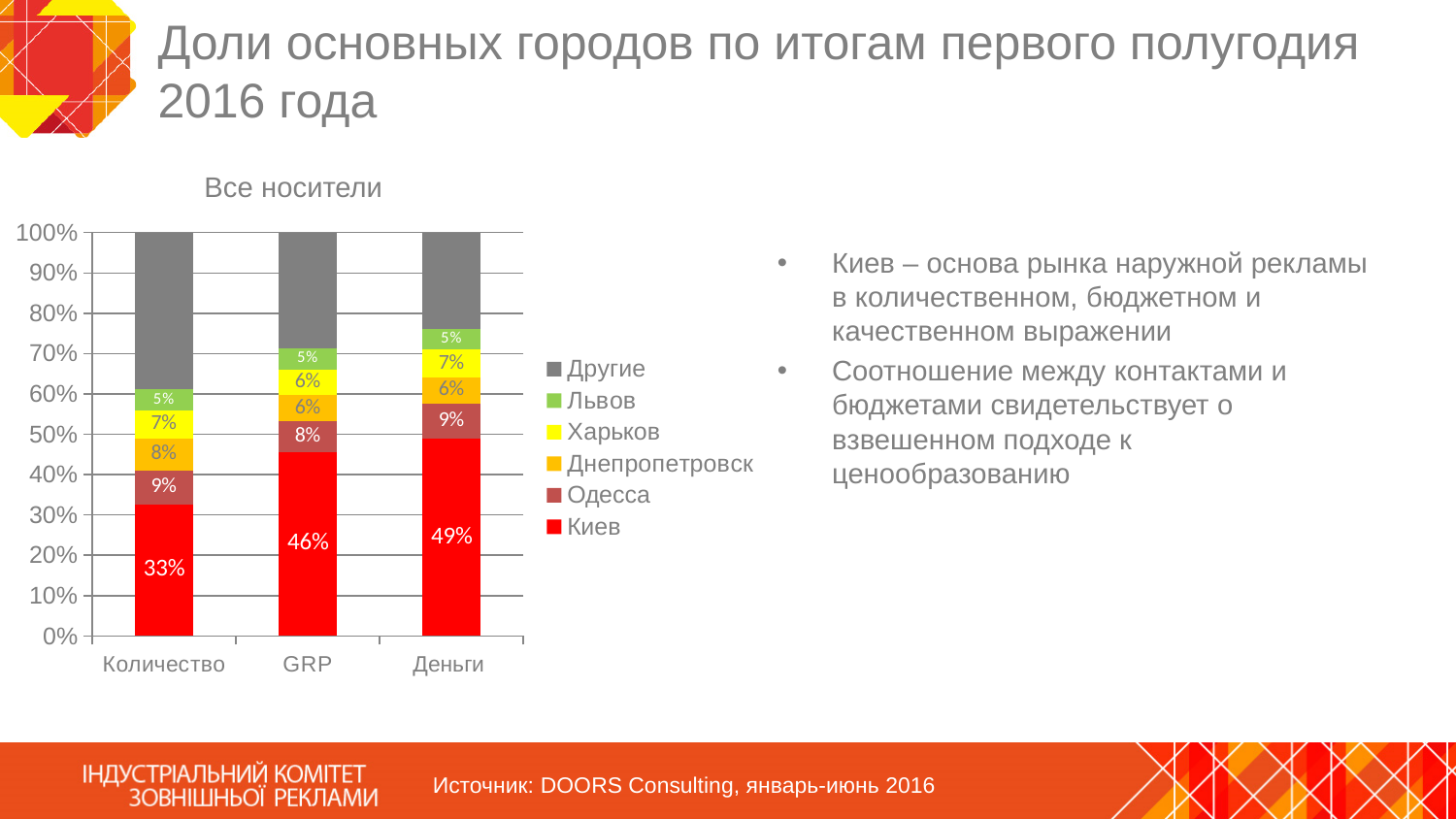
In which category does Киев have its highest share? Деньги Which is larger: the share of Киев in GRP or in Деньги? Деньги What is the share of Киев in the GRP bar? 46% How many series does the legend list? 6 What is the share of Киев in the Деньги bar? 49% What is the share of Одесса in the Количество bar? 9% What is the share of Днепропетровск in the GRP bar? 6% What is the difference between the share of Киев in Деньги and in Количество? 16 percentage points What kind of chart is shown on the slide? stacked bar chart What is the share of Харьков in the Деньги bar? 7% What is the share of Киев in the Количество bar? 33% Does the share of Киев rise or fall from Количество to Деньги? rise